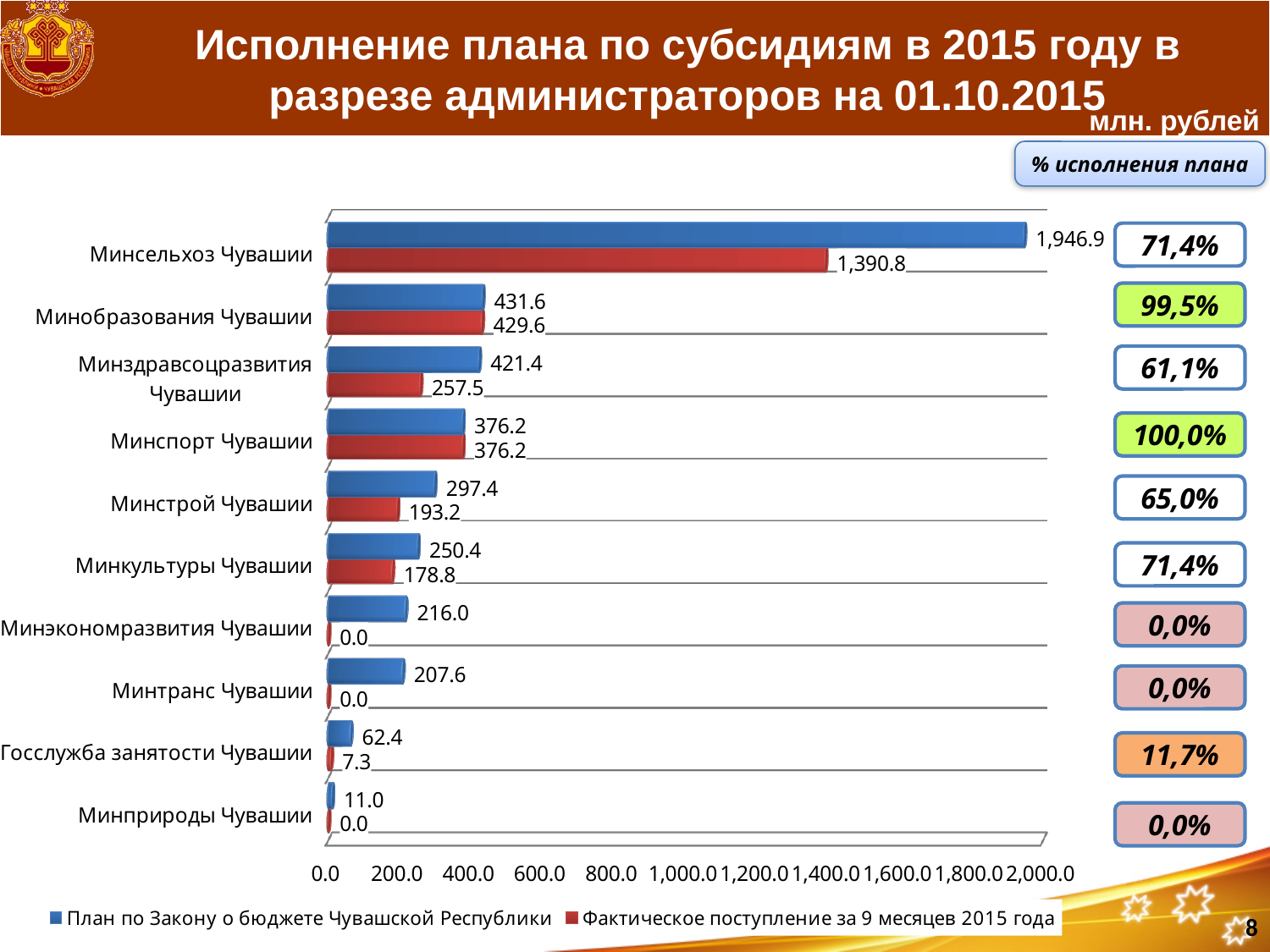
What colour represents 'Фактическое поступление за 9 месяцев 2015 года' in the chart? Red What is the value of 'Фактическое поступление за 9 месяцев 2015 года' for Госслужба занятости Чувашии? 7.3 What kind of chart is shown on the slide? Bar chart How many categories are shown on the chart? 10 What is the value of 'Фактическое поступление за 9 месяцев 2015 года' for Минздравсоцразвития Чувашии? 257.5 What is the percentage of plan execution shown for Минспорт Чувашии? 100,0% How many series does the legend list? 2 What is the value of 'План по Закону о бюджете Чувашской Республики' for Минсельхоз Чувашии? 1,946.9 Which is larger for Минкультуры Чувашии: the plan value or the actual value? The plan value (250.4) Which category has the lowest value for 'План по Закону о бюджете Чувашской Республики'? Минприроды Чувашии What is the difference between the plan value and the actual value for Минстрой Чувашии? 104.2 Which category has the highest value for 'План по Закону о бюджете Чувашской Республики'? Минсельхоз Чувашии